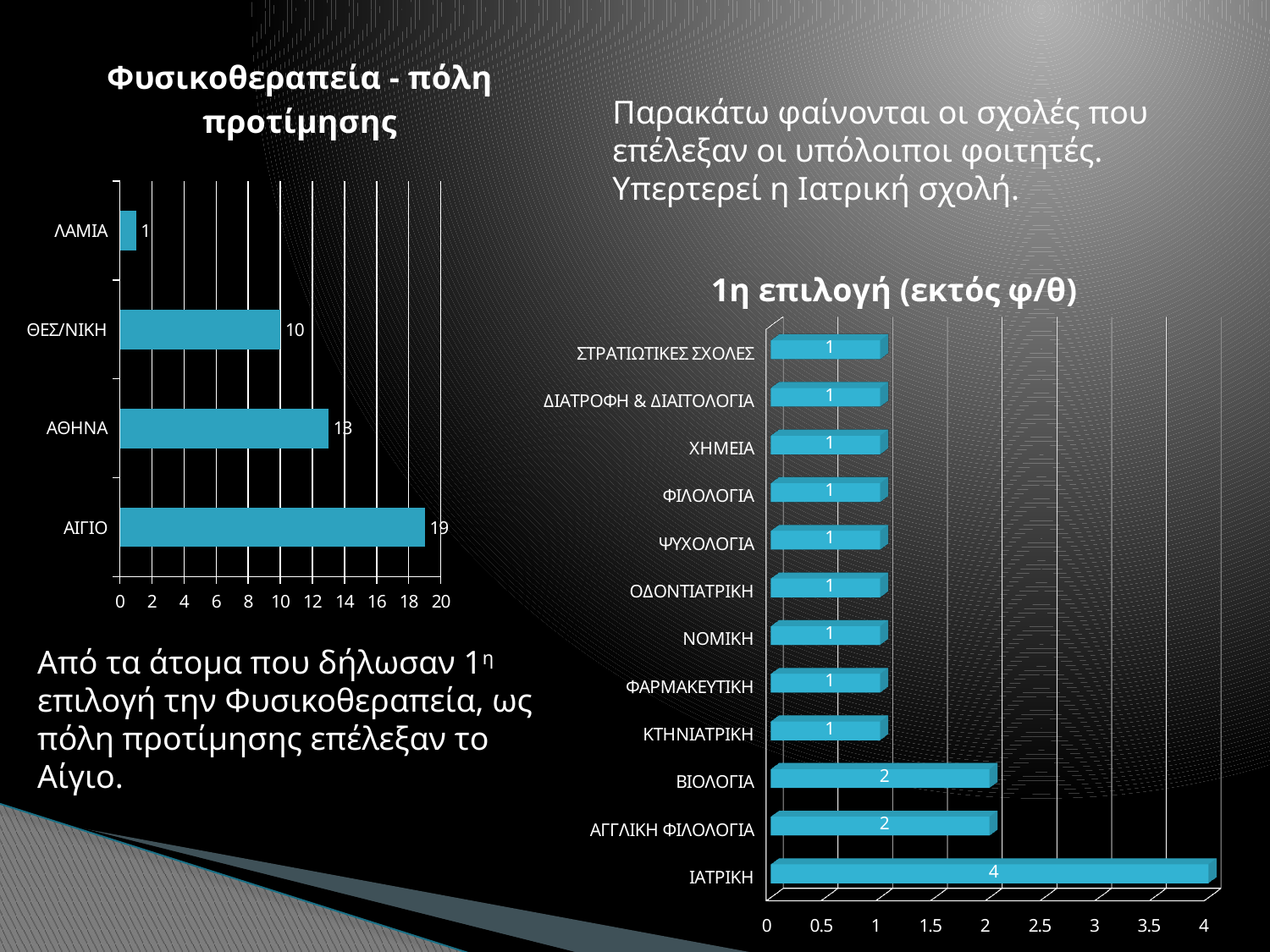
In the chart titled 'Φυσικοθεραπεία - πόλη προτίμησης', which city has the lowest value? ΛΑΜΙΑ In the chart titled '1η επιλογή (εκτός φ/θ)', what is the value for ΒΙΟΛΟΓΙΑ? 2 In the chart titled 'Φυσικοθεραπεία - πόλη προτίμησης', what is the value for ΑΙΓΙΟ? 19 In the chart titled 'Φυσικοθεραπεία - πόλη προτίμησης', which is larger, the value for ΑΘΗΝΑ or ΘΕΣ/ΝΙΚΗ? ΑΘΗΝΑ In the chart titled '1η επιλογή (εκτός φ/θ)', what is the difference between the values for ΙΑΤΡΙΚΗ and ΑΓΓΛΙΚΗ ΦΙΛΟΛΟΓΙΑ? 2 What kind of chart is the chart titled '1η επιλογή (εκτός φ/θ)'? Bar chart In the chart titled 'Φυσικοθεραπεία - πόλη προτίμησης', how many cities are shown? 4 In the chart titled '1η επιλογή (εκτός φ/θ)', how many categories are shown? 12 In the chart titled '1η επιλογή (εκτός φ/θ)', which category has the highest value? ΙΑΤΡΙΚΗ In the chart titled '1η επιλογή (εκτός φ/θ)', what is the value for ΝΟΜΙΚΗ? 1 In the chart titled 'Φυσικοθεραπεία - πόλη προτίμησης', what is the value for ΘΕΣ/ΝΙΚΗ? 10 In the chart titled 'Φυσικοθεραπεία - πόλη προτίμησης', what is the difference between the values for ΑΙΓΙΟ and ΑΘΗΝΑ? 6